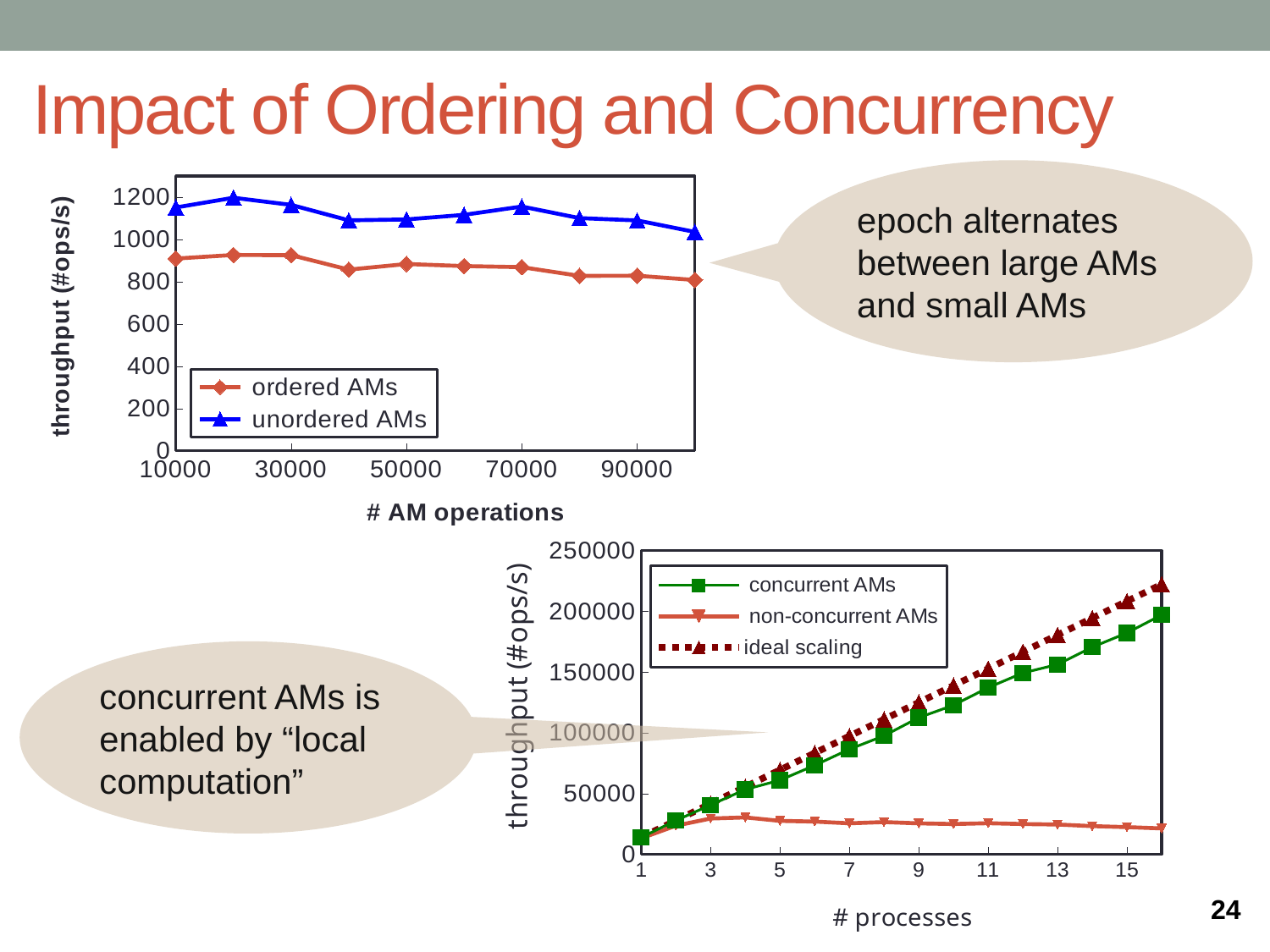
In the top-left chart (# AM operations), which series has the higher throughput at 50000 AM operations, ordered AMs or unordered AMs? unordered AMs In the bottom-right chart (# processes), is the throughput for non-concurrent AMs at 16 processes greater or less than 50000? less In the top-left chart (# AM operations), is the throughput for unordered AMs at 20000 AM operations greater or less than 1000? greater What kind of chart is the top-left chart with the x axis '# AM operations'? line chart In the top-left chart (# AM operations), is the throughput for ordered AMs at 10000 AM operations greater or less than 1000? less In the bottom-right chart (# processes), which series has the higher throughput at 16 processes, concurrent AMs or non-concurrent AMs? concurrent AMs In the bottom-right chart (# processes), how many series does the legend list? 3 In the bottom-right chart (# processes), which series is drawn with a dotted line? ideal scaling In the bottom-right chart (# processes), does the throughput for concurrent AMs rise or fall as the number of processes increases? rise In the top-left chart (# AM operations), how many data points does the ordered AMs series have? 10 In the top-left chart (# AM operations), how many series does the legend list? 2